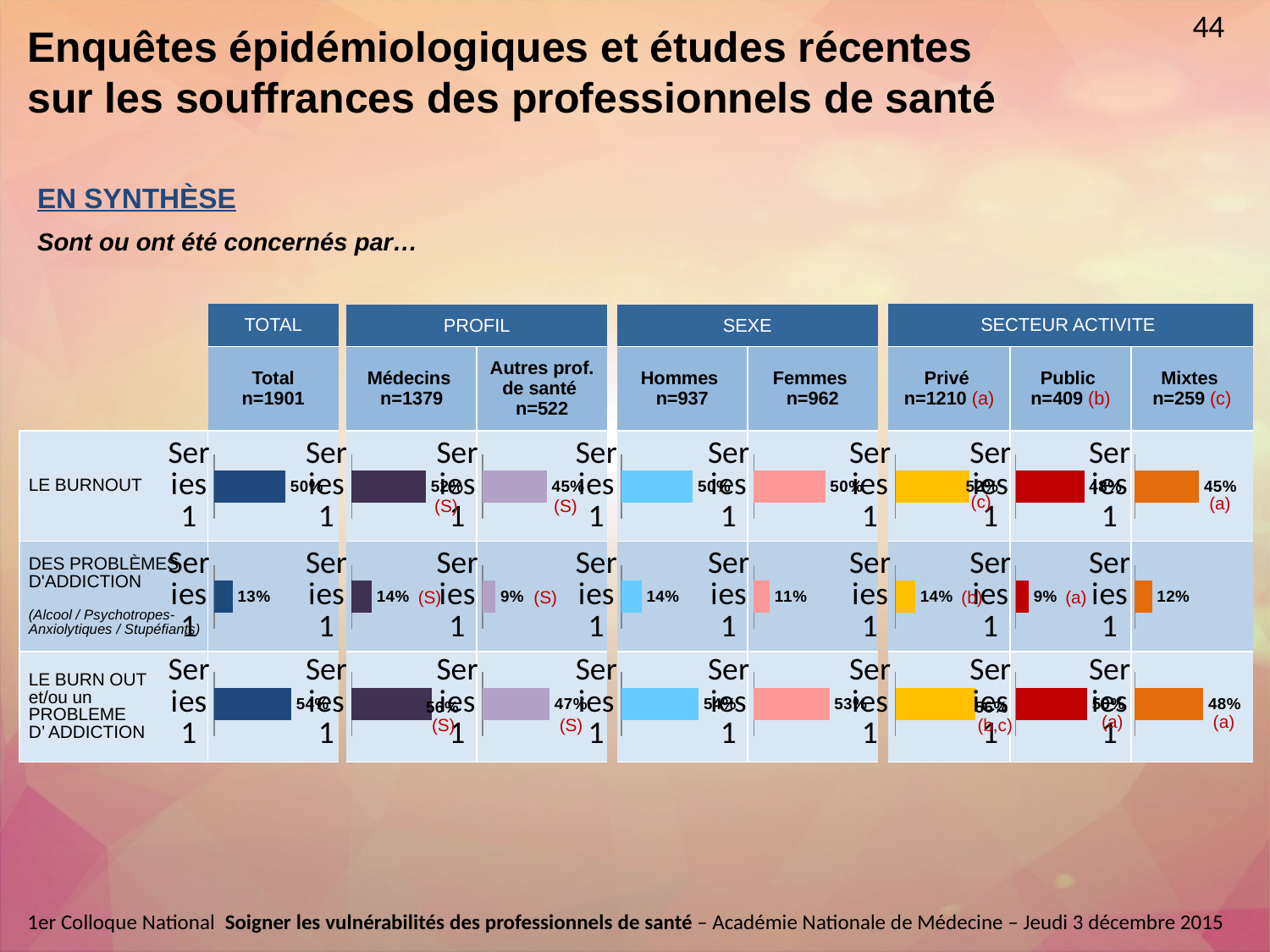
In the 'LE BURN OUT et/ou un PROBLEME D'ADDICTION' row, what value is shown for Mixtes (n=259)? 48% In the 'DES PROBLÈMES D'ADDICTION' row, what is the difference between the Privé value and the Public value? 5% In the 'DES PROBLÈMES D'ADDICTION' row, what value is shown for Femmes (n=962)? 11% In the 'DES PROBLÈMES D'ADDICTION' row, what is the difference between the Hommes value and the Femmes value? 3% In the 'LE BURN OUT et/ou un PROBLEME D'ADDICTION' row, what value is shown for Femmes (n=962)? 53% What kind of chart is used in each cell of the table? Bar chart How many bars are plotted in each individual chart cell of the table? 1 In the 'LE BURNOUT' row, what value is shown for Autres prof. de santé (n=522)? 45% In the 'DES PROBLÈMES D'ADDICTION' row, which is larger: the Médecins value or the Autres prof. de santé value? Médecins In the 'DES PROBLÈMES D'ADDICTION' row, which sector (Privé, Public or Mixtes) has the lowest value? Public In the 'LE BURNOUT' row, what value is shown for Mixtes (n=259)? 45% In the 'DES PROBLÈMES D'ADDICTION' row, what value is shown for the Total (n=1901) bar? 13%